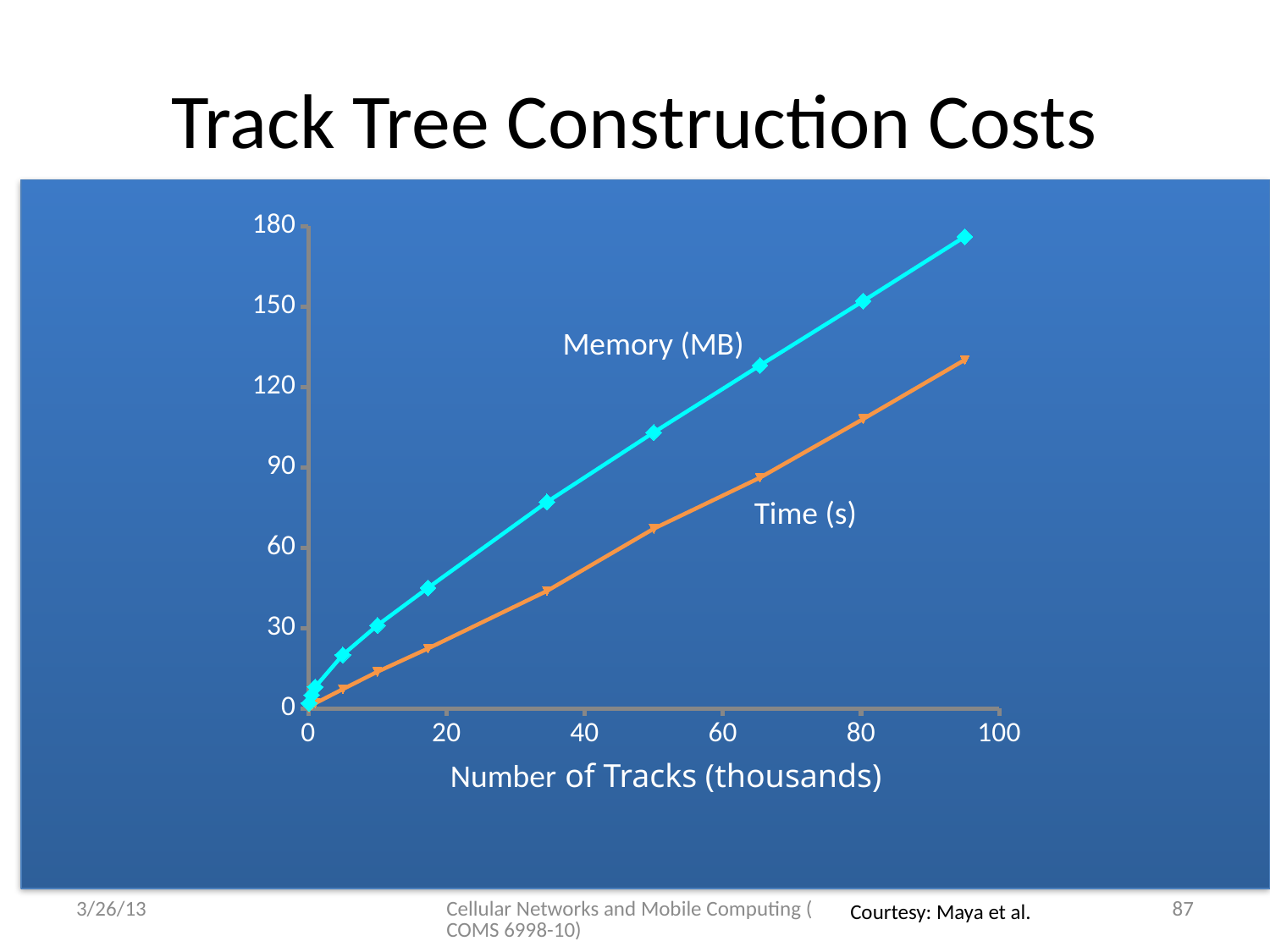
What is the label of the x axis? Number of Tracks (thousands) Which series has the higher value at the rightmost data point, Memory (MB) or Time (s)? Memory (MB) Is the value of the Time (s) series at its rightmost point greater or less than 120? greater Is the value of the Memory (MB) series at its rightmost point greater or less than 150? greater Does the Memory (MB) series rise or fall as the number of tracks increases? rise Does the Time (s) series rise or fall as the number of tracks increases? rise Is the value of the Time (s) series at about 80 thousand tracks greater or less than 90? greater What is the title of the slide's chart? Track Tree Construction Costs How many series are plotted on the chart? 2 What kind of chart is shown on the slide? line chart